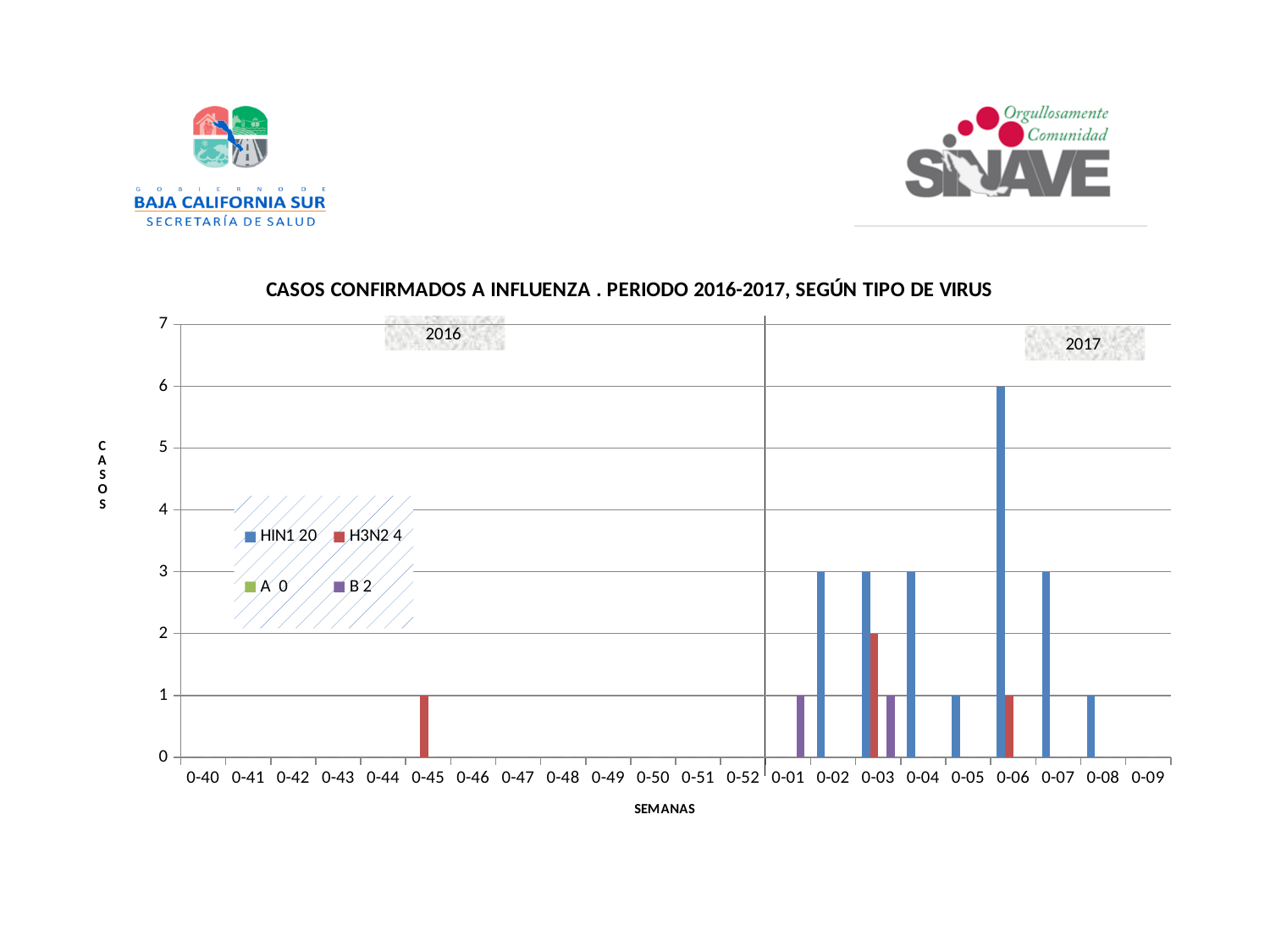
What total number of cases does the legend give for the HIN1 series? 20 What kind of chart is shown on the slide? bar chart What is the H3N2 value for week 0-45? 1 How many week categories are shown on the x axis? 22 How many series does the legend list? 4 What is the difference between the HIN1 value for week 0-06 and the HIN1 value for week 0-07? 3 What is the HIN1 value for week 0-05? 1 What is the H3N2 value for week 0-03? 2 In which week does the HIN1 series reach its highest value? 0-06 What is the title of the chart? CASOS CONFIRMADOS A INFLUENZA . PERIODO 2016-2017, SEGÚN TIPO DE VIRUS What is the HIN1 value for week 0-06? 6 Which is larger, the HIN1 value for week 0-02 or the HIN1 value for week 0-08? 0-02